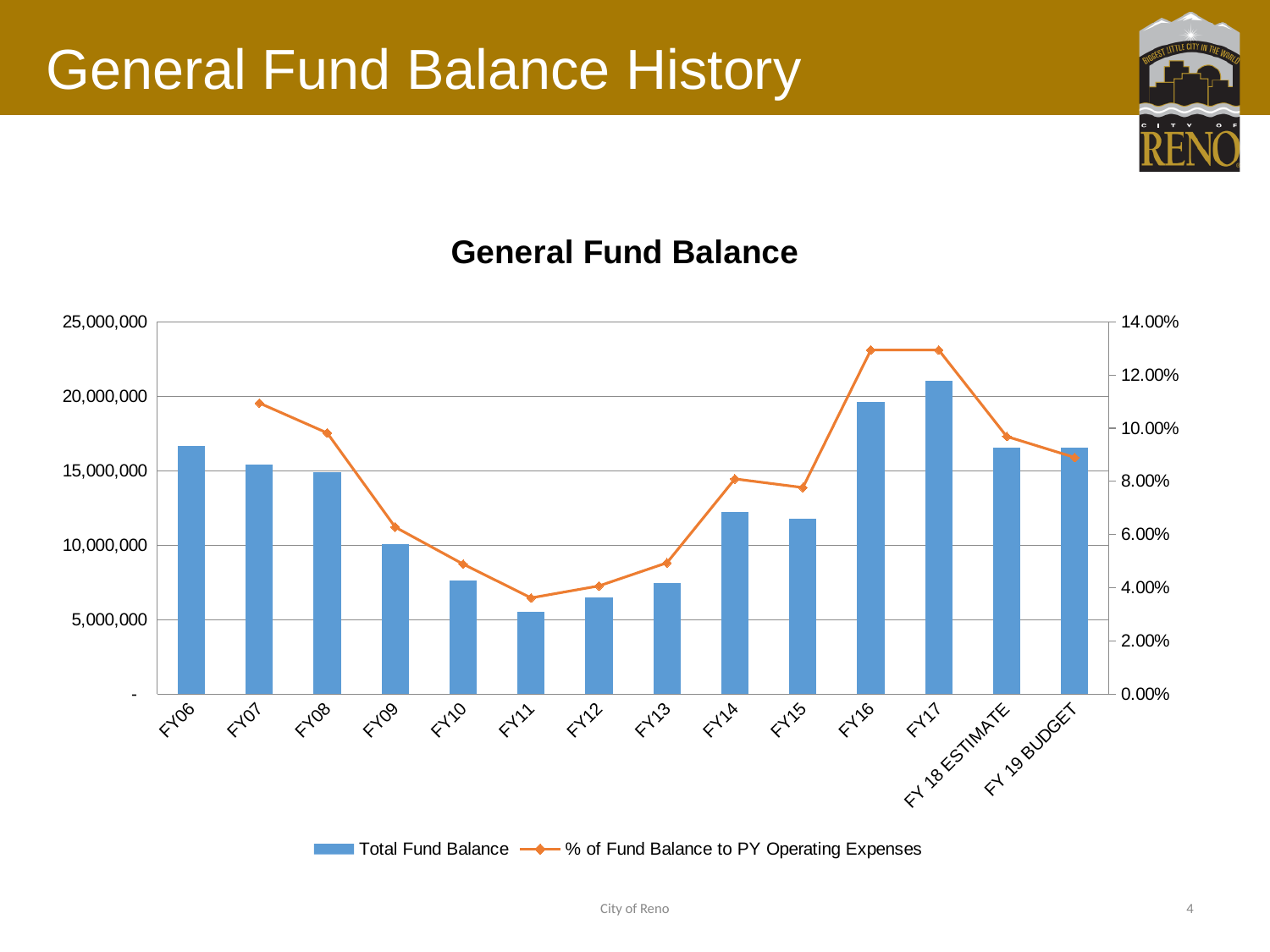
Which has the larger Total Fund Balance, FY15 or FY16? FY16 What kind of chart is shown on the slide? A combined bar and line chart Is the Total Fund Balance for FY10 greater or less than 10,000,000? less Does the Total Fund Balance rise or fall from FY06 to FY11? fall Is the Total Fund Balance for FY17 greater or less than 20,000,000? greater Which fiscal year has the highest Total Fund Balance bar? FY17 What is the title of the chart? General Fund Balance Which fiscal year has the lowest value for % of Fund Balance to PY Operating Expenses? FY11 Which fiscal year has the lowest Total Fund Balance bar? FY11 How many fiscal-year categories are shown on the x axis? 14 Is the % of Fund Balance to PY Operating Expenses for FY16 greater or less than 12.00%? greater How many series does the legend list? 2